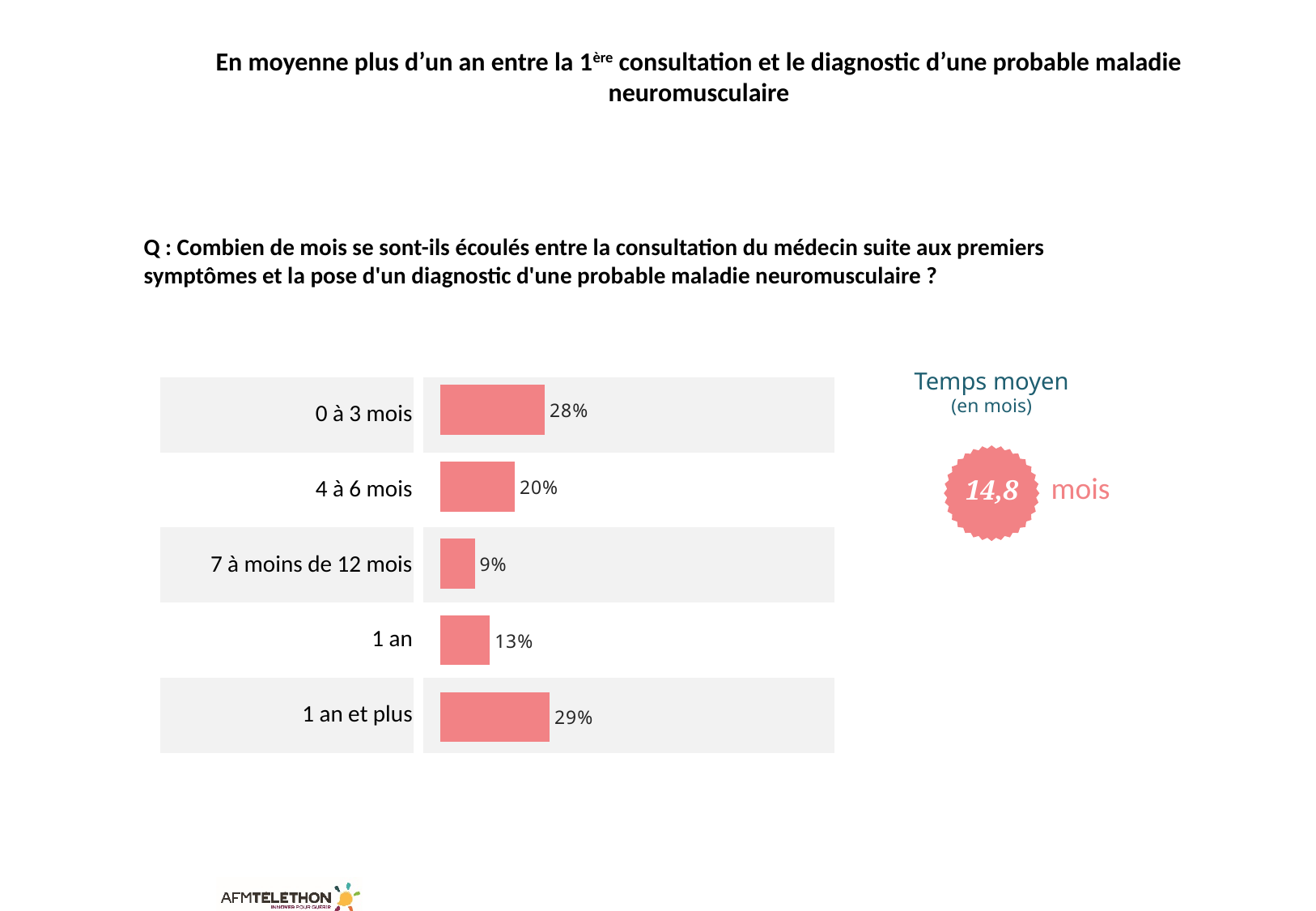
How many categories does the chart show? 5 What is the value for "4 à 6 mois"? 20% What is the value for "0 à 3 mois"? 28% Which is larger, the value for "1 an" or the value for "7 à moins de 12 mois"? 1 an What is the value for "7 à moins de 12 mois"? 9% Which category has the lowest value? 7 à moins de 12 mois What is the value for "1 an et plus"? 29% Which category has the highest value? 1 an et plus What average time in months (Temps moyen) is shown next to the chart? 14,8 mois What is the difference between the values for "0 à 3 mois" and "4 à 6 mois"? 8% What is the value for "1 an"? 13% What kind of chart is shown on the slide? Bar chart